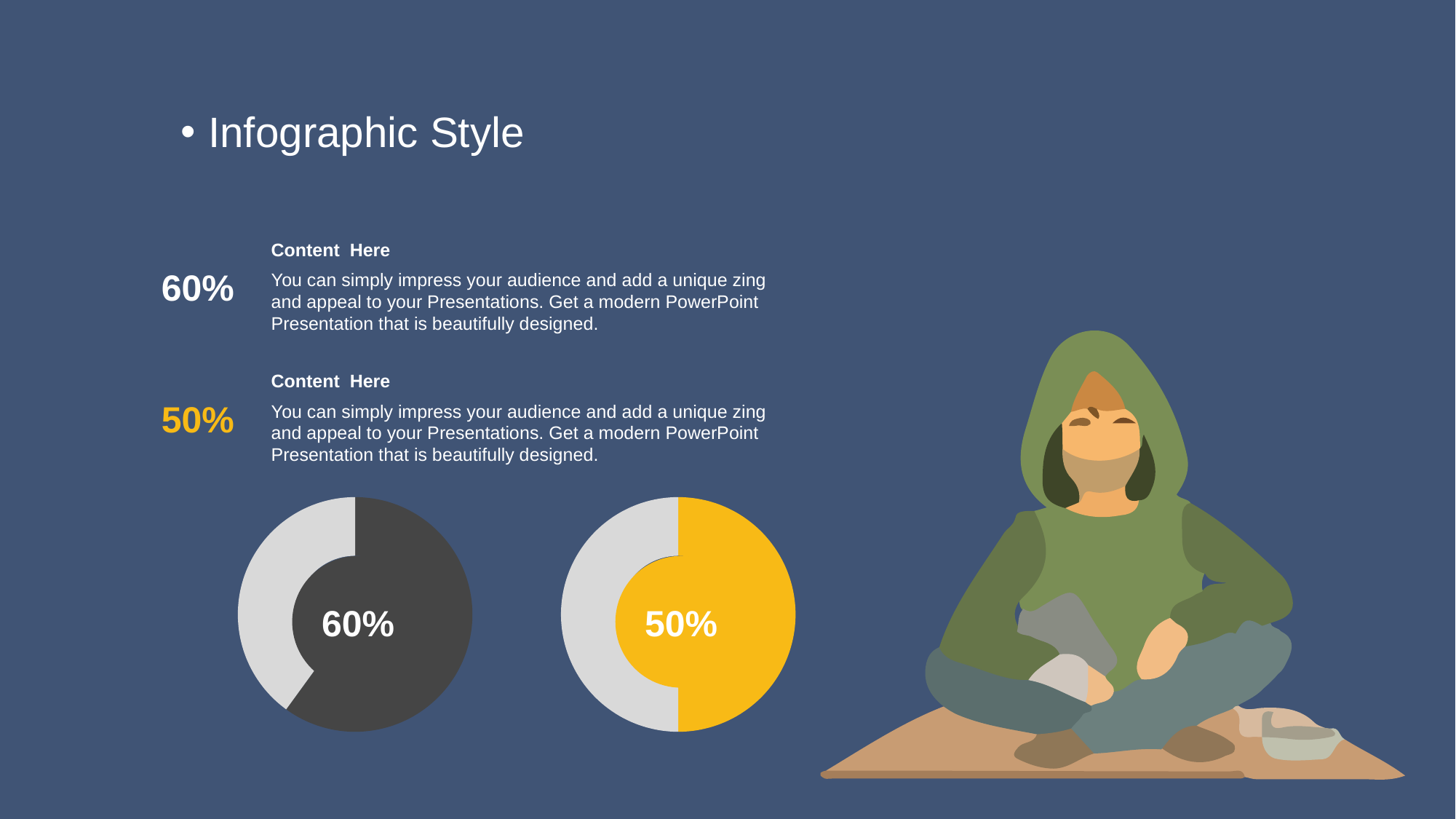
In the left pie chart, what value is shown in the dark grey slice? 60% What colour is the slice labelled 50% in the right pie chart? yellow What kind of chart is the left chart on the slide? doughnut chart What colour is the slice labelled 60% in the left pie chart? dark grey Which chart has the smaller labelled value, the left pie chart or the right pie chart? the right pie chart What is the difference between the value labelled on the left pie chart and the value labelled on the right pie chart? 10% How many slices does the right pie chart have? 2 How many charts are shown on the slide? 2 Which chart shows the larger labelled value, the left pie chart or the right pie chart? the left pie chart In the right pie chart, what value is shown in the yellow slice? 50% What kind of chart is the right chart on the slide? doughnut chart How many slices does the left pie chart have? 2